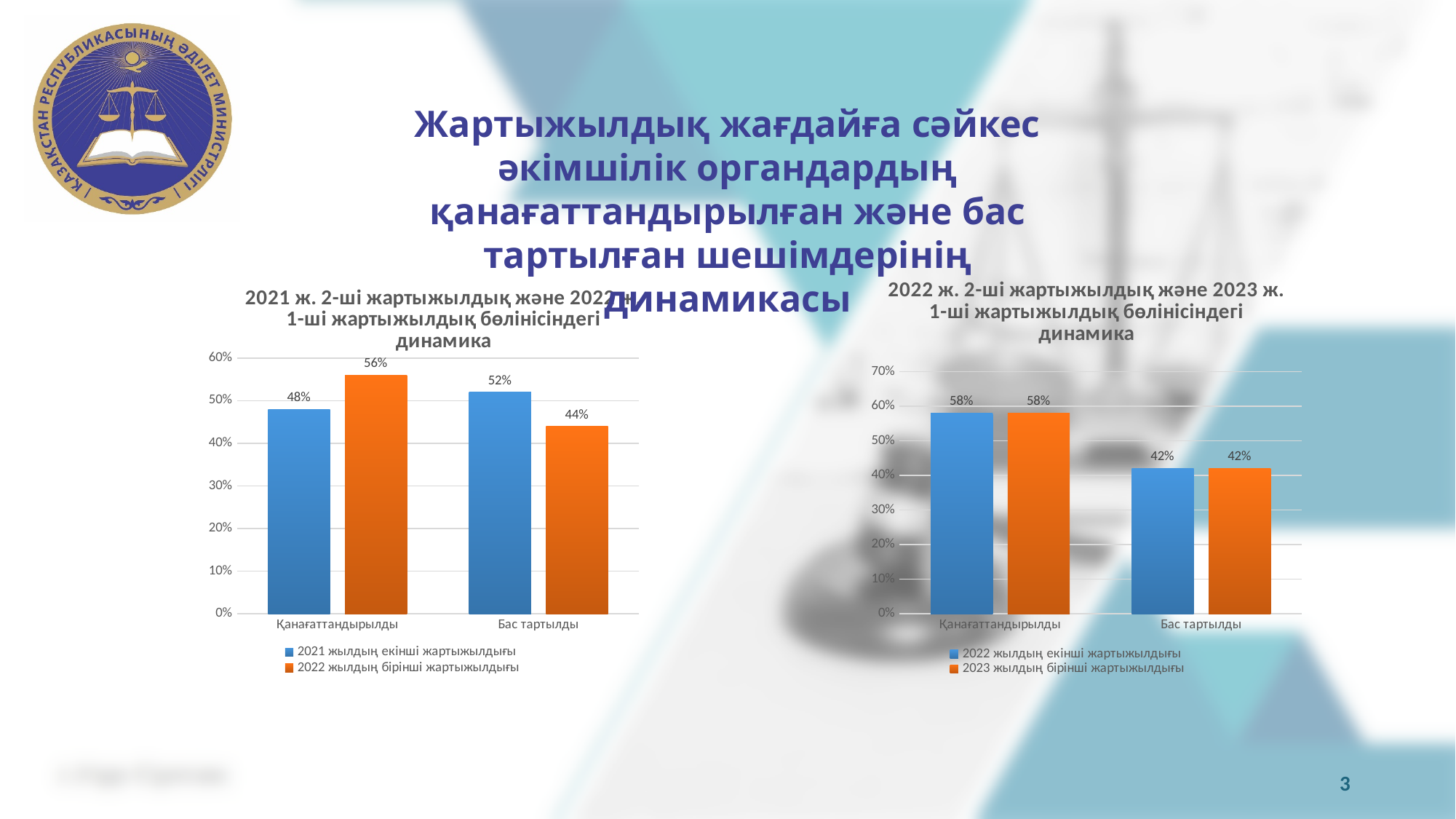
In the left chart, what is the value for Бас тартылды in the 2021 жылдың екінші жартыжылдығы series? 52% In the right chart, what is the value for Қанағаттандырылды in the 2023 жылдың бірінші жартыжылдығы series? 58% In the left chart, what is the value for Бас тартылды in the 2022 жылдың бірінші жартыжылдығы series? 44% How many series does the legend of the right chart list? 2 How many categories are shown on the x axis of the left chart? 2 What type of chart is the right chart? Bar chart In the left chart, what is the value for Қанағаттандырылды in the 2021 жылдың екінші жартыжылдығы series? 48% In the right chart, what is the value for Бас тартылды in the 2022 жылдың екінші жартыжылдығы series? 42% In the left chart, what is the value for Қанағаттандырылды in the 2022 жылдың бірінші жартыжылдығы series? 56% In the right chart, what is the difference between Қанағаттандырылды and Бас тартылды in the 2023 жылдың бірінші жартыжылдығы series? 16% In the left chart, what is the difference between the two series' values for Бас тартылды? 8% In the left chart, which series has the larger value for Қанағаттандырылды? 2022 жылдың бірінші жартыжылдығы